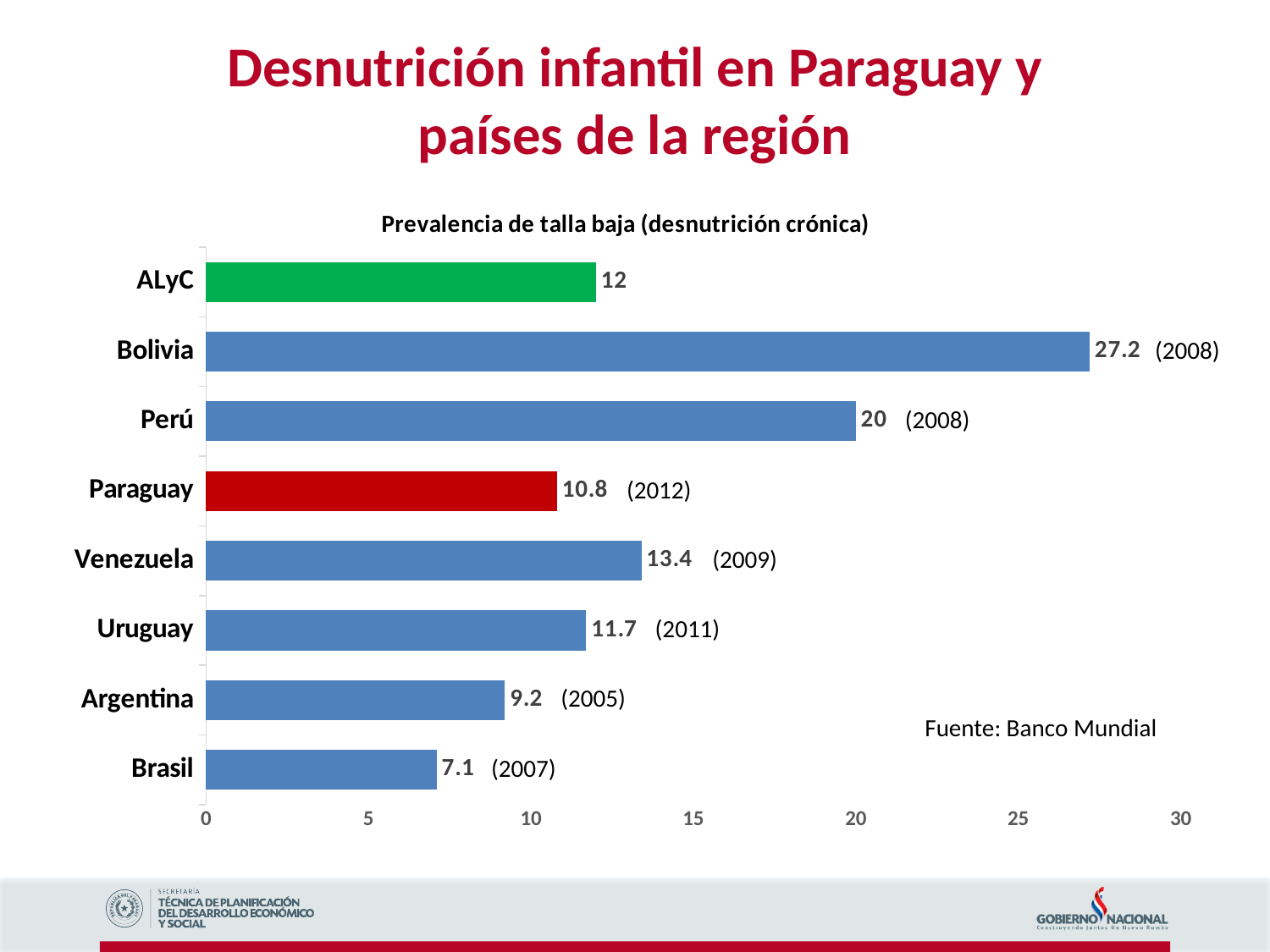
Which has a larger value, Uruguay or Argentina? Uruguay What is the difference between the values for Bolivia and Perú? 7.2 What is the difference between the values for Venezuela and Paraguay? 2.6 What is the value for ALyC? 12 Which country has the highest prevalence of stunting? Bolivia Which country has the lowest prevalence of stunting? Brasil Is the value for Perú greater or less than 15? greater What is the value for Paraguay? 10.8 What is the title of the chart? Prevalencia de talla baja (desnutrición crónica) What is the value for Bolivia? 27.2 What kind of chart is shown on the slide? bar chart How many bars are shown in the chart? 8